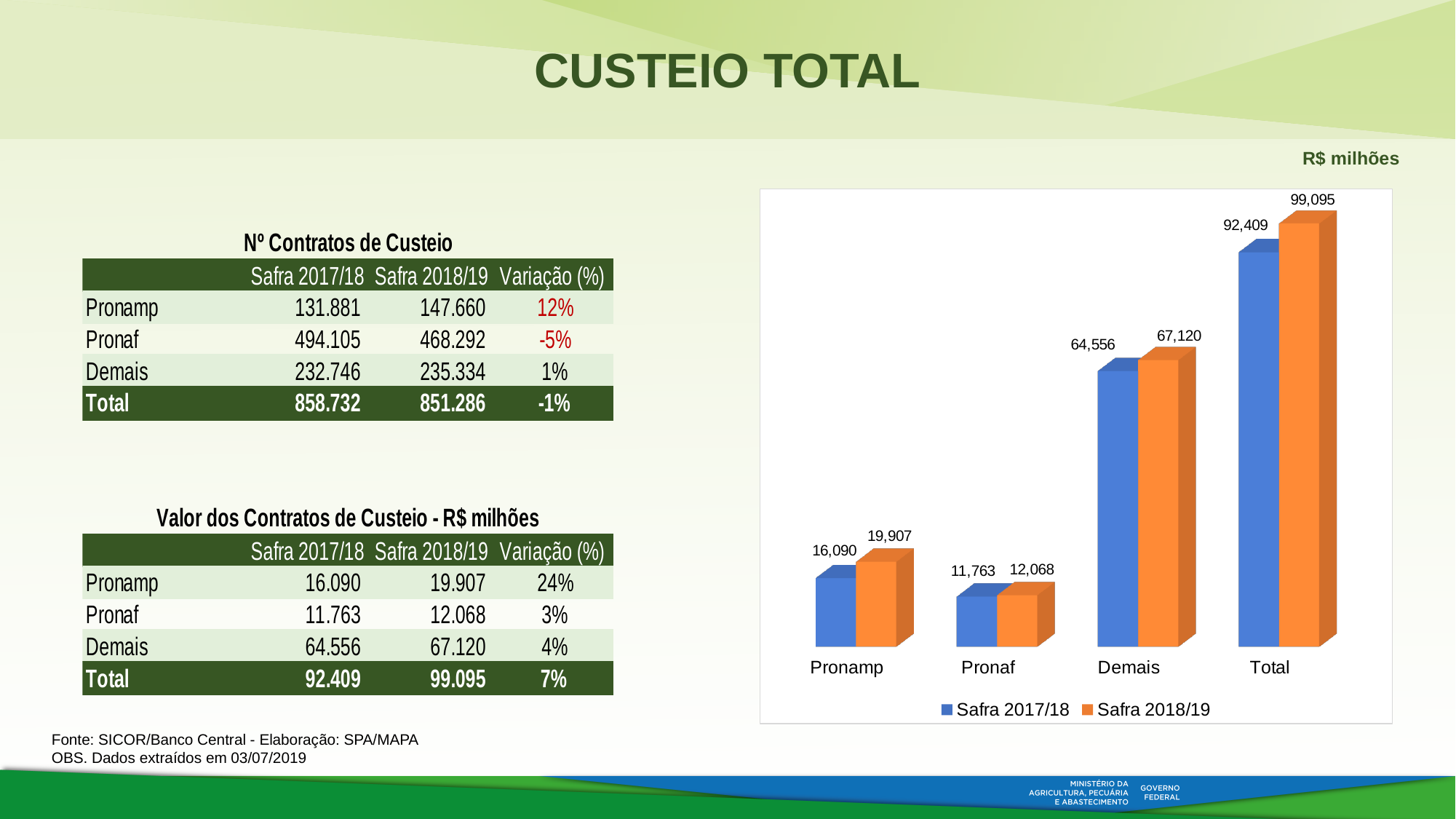
How many series does the chart legend list? 2 Which category has the lowest value in the Safra 2017/18 series? Pronaf What kind of chart is shown on the slide? Bar chart What is the value for Pronamp in the Safra 2018/19 series? 19,907 Excluding the Total bars, which category has the highest value in the Safra 2018/19 series? Demais What is the value for Demais in the Safra 2017/18 series? 64,556 What is the value for Total in the Safra 2017/18 series? 92,409 What is the difference between the Safra 2018/19 and Safra 2017/18 values for Total? 6,686 Which is larger: the Safra 2017/18 value for Pronamp or the Safra 2018/19 value for Pronaf? Safra 2017/18 value for Pronamp How many categories are shown on the x axis of the chart? 4 What is the difference between the Safra 2018/19 and Safra 2017/18 values for Pronamp? 3,817 What is the value for Pronaf in the Safra 2018/19 series? 12,068